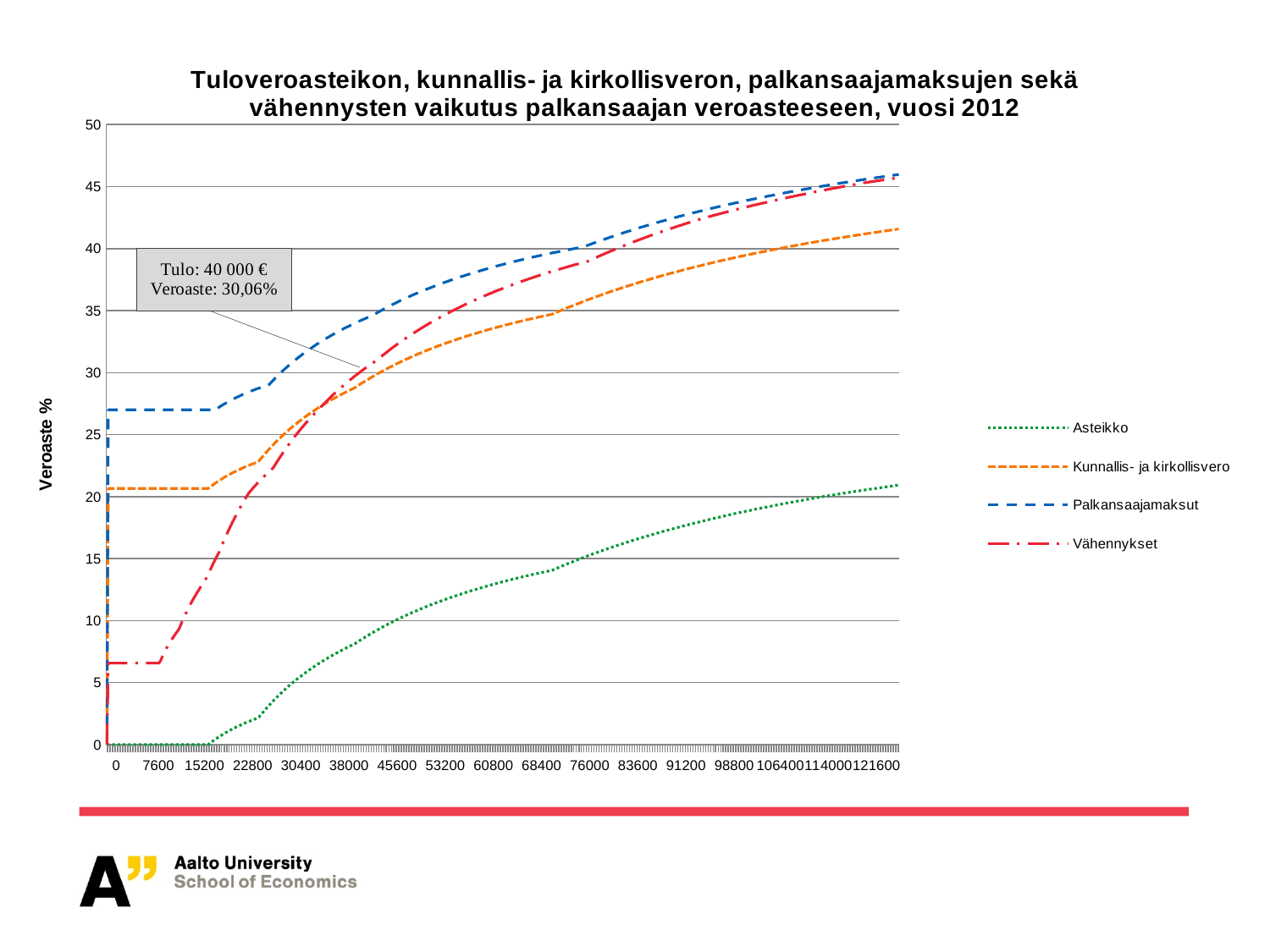
Is the value of Vähennykset at income 7600 greater or less than 10? less According to the annotation, what is the tax rate (veroaste) at an income of 40 000 €? 30,06% At income 22800, which is higher: Palkansaajamaksut or Vähennykset? Palkansaajamaksut What kind of chart is shown on the slide? line chart Is the value of Asteikko at income 60800 greater or less than 10? greater What is the label of the vertical axis? Veroaste % Which series has the lowest values across the whole income range? Asteikko How many series does the legend list? 4 Does the Asteikko series rise or fall as income increases along the x axis? rise At income 121600, which is higher: Palkansaajamaksut or Kunnallis- ja kirkollisvero? Palkansaajamaksut Which series is drawn with the green dotted line? Asteikko